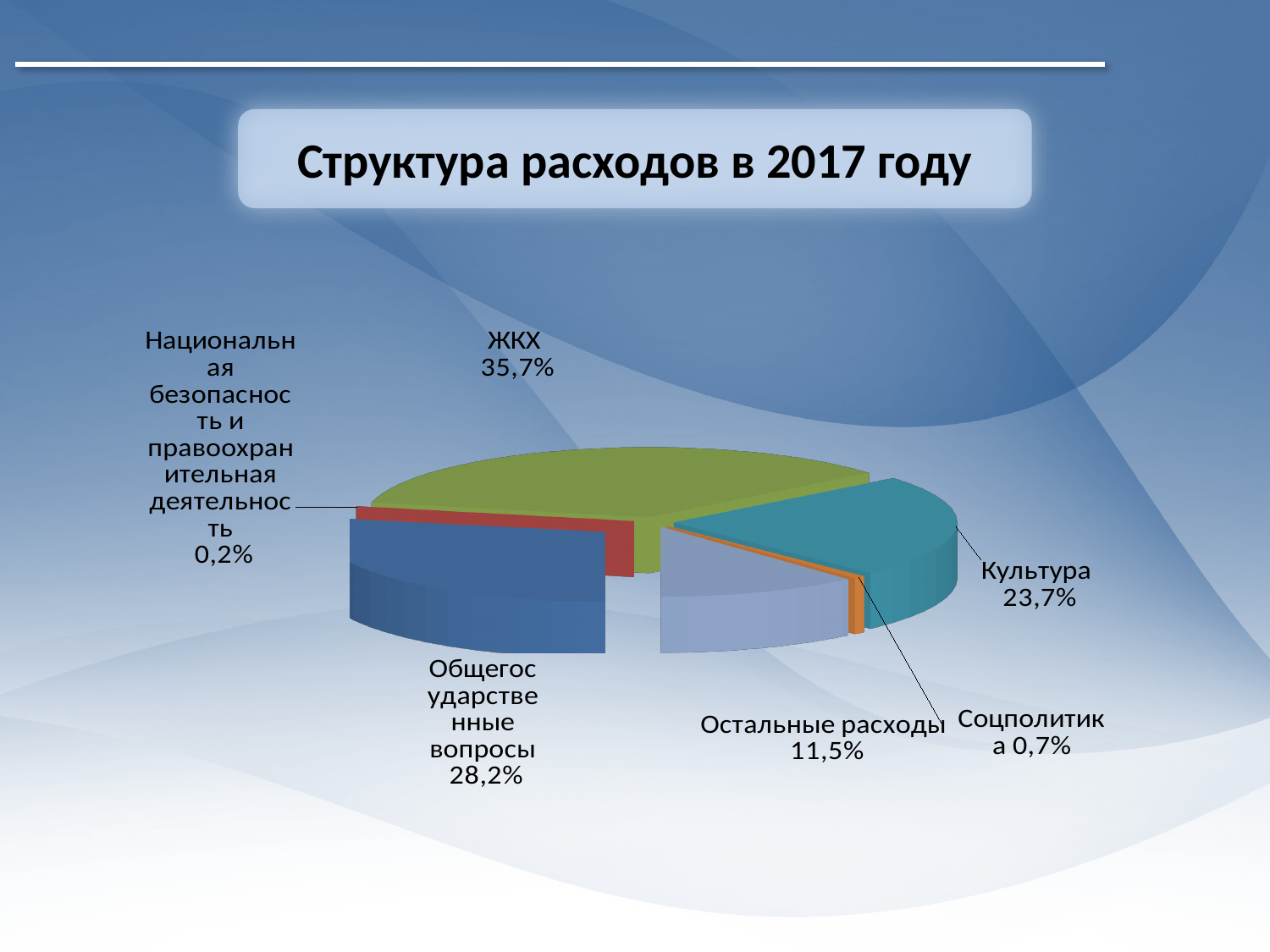
What kind of chart is shown on the slide? pie chart What is the difference in percentage points between ЖКХ and Культура? 12,0 percentage points What is the value shown for Культура? 23,7% What share of expenses does ЖКХ account for? 35,7% What is the value shown for Общегосударственные вопросы? 28,2% What is the title of the chart? Структура расходов в 2017 году Which category has the largest share of expenses? ЖКХ Which is larger, the share for Общегосударственные вопросы or the share for Остальные расходы? Общегосударственные вопросы How many slices does the pie chart have? 6 What is the value shown for Соцполитика? 0,7% What is the value shown for Остальные расходы? 11,5% Which category has the smallest share of expenses? Национальная безопасность и правоохранительная деятельность